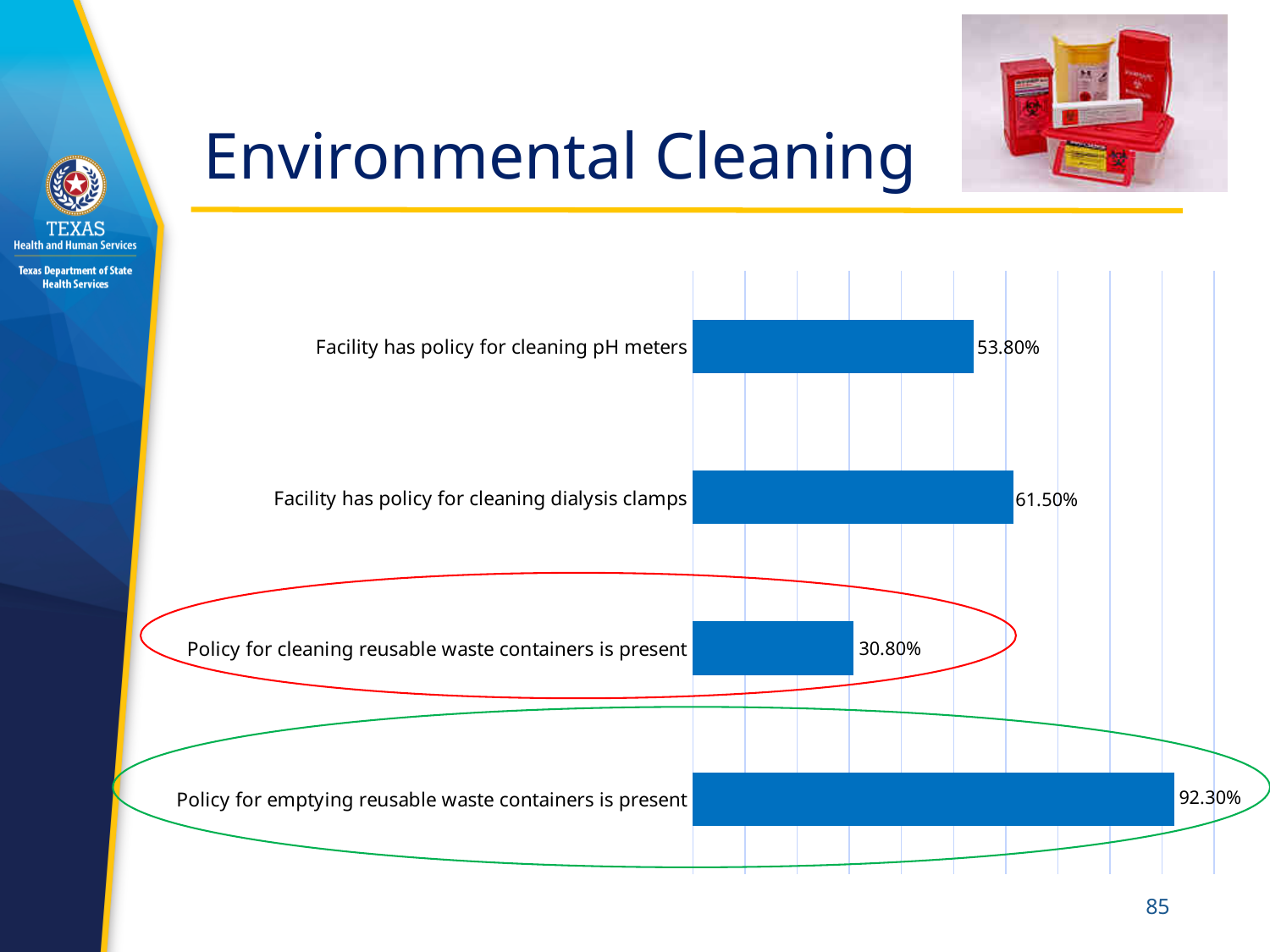
What is the difference between the value for emptying reusable waste containers and the value for cleaning reusable waste containers? 61.50% What kind of chart is shown on the slide? Bar chart What is the value for "Policy for cleaning reusable waste containers is present"? 30.80% What is the value for "Facility has policy for cleaning dialysis clamps"? 61.50% Which is larger: the value for cleaning dialysis clamps or the value for cleaning pH meters? Facility has policy for cleaning dialysis clamps What is the value for "Policy for emptying reusable waste containers is present"? 92.30% Which category has the lowest value? Policy for cleaning reusable waste containers is present What is the value for "Facility has policy for cleaning pH meters"? 53.80% How many categories are shown in the chart? 4 Which category is circled in red on the chart? Policy for cleaning reusable waste containers is present Which category has the highest value? Policy for emptying reusable waste containers is present What is the difference between the value for cleaning dialysis clamps and the value for cleaning pH meters? 7.70%